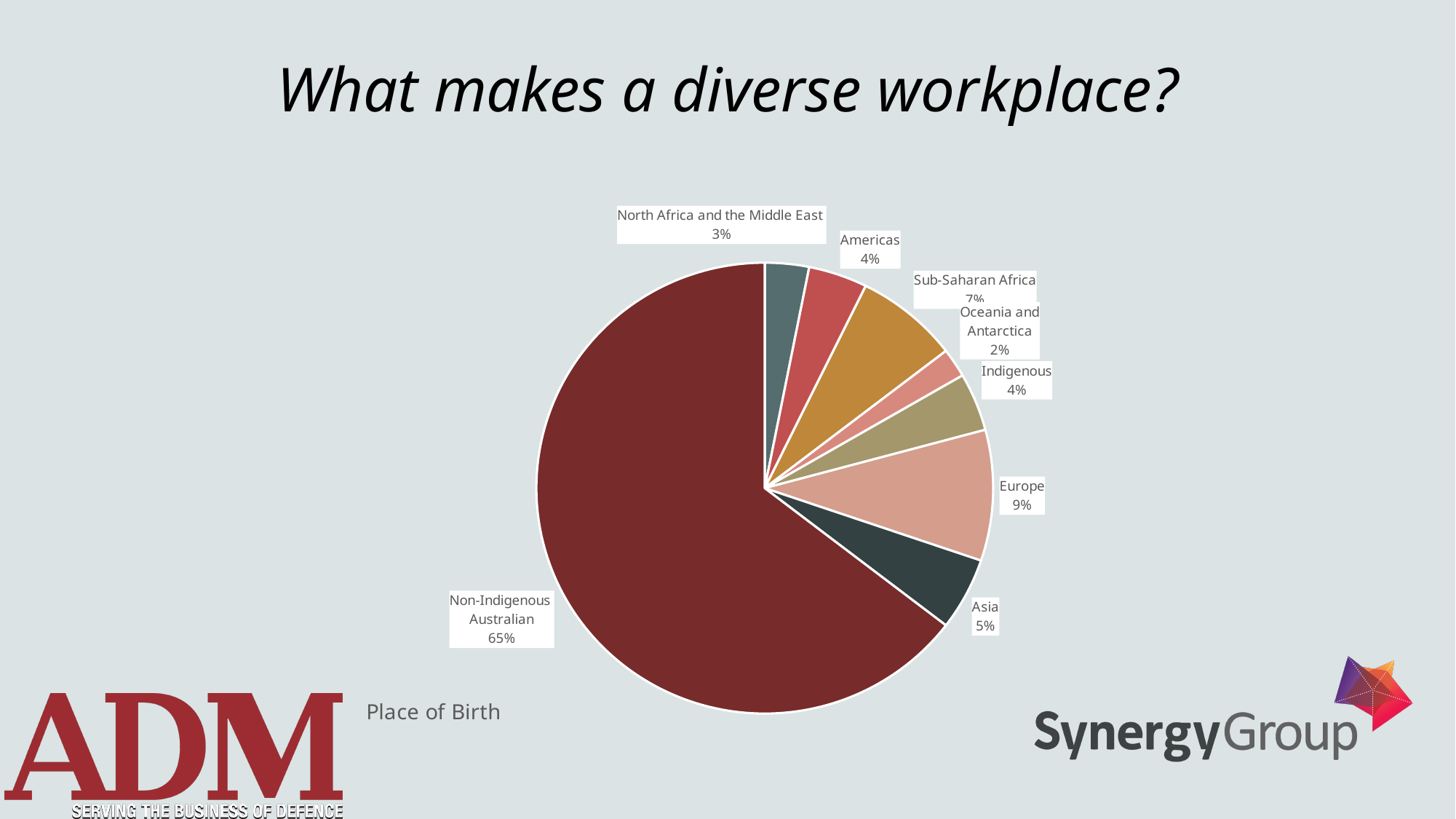
What is the value shown for Asia? 5% What is the value shown for Oceania and Antarctica? 2% What kind of chart is shown on the slide? Pie chart Which category has the smallest slice of the pie? Oceania and Antarctica Which category has the largest slice of the pie? Non-Indigenous Australian What is the value shown for North Africa and the Middle East? 3% What is the title of the chart? Place of Birth What is the value shown for Europe? 9% What share of the pie does Non-Indigenous Australian hold? 65% What is the difference between the Europe and Asia values? 4% Which is larger, the value for Europe or the value for Americas? Europe How many categories are shown in the pie chart? 8